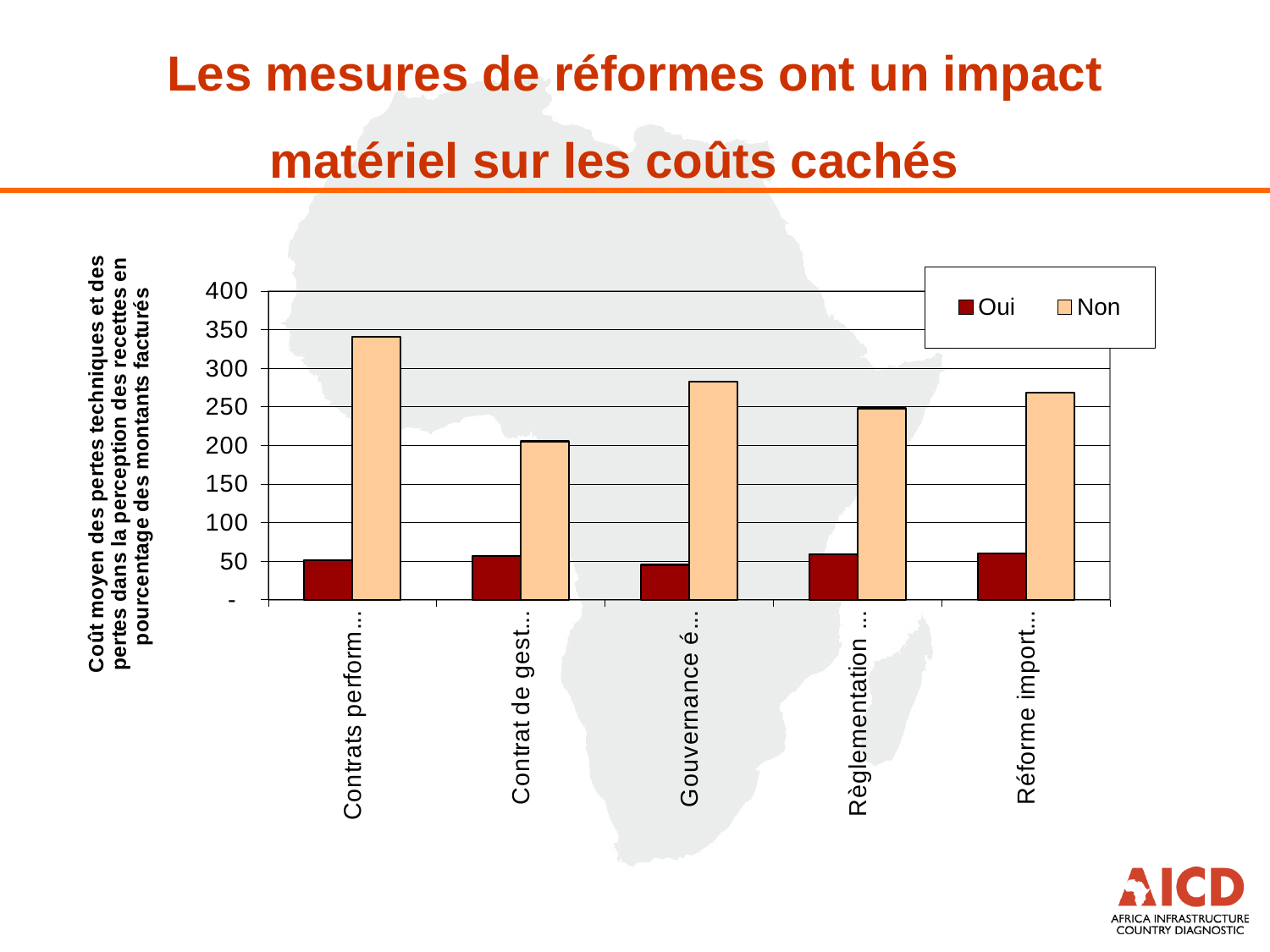
Is the Non value for the first category (Contrats perform...) greater or less than 300? greater Which colour represents the Oui series in the chart? dark red Which category has the lowest value for the Non series? Contrat de gest... (the second category) Is the Oui value for the fourth category (Règlementation ...) greater or less than 100? less For the fifth category (Réforme import...), which series has the larger value, Oui or Non? Non Is the Non value for the third category (Gouvernance é...) greater or less than 250? greater How many series does the legend list? 2 How many categories are shown on the x axis? 5 What are the two series named in the legend? Oui and Non Which category has the highest value for the Non series? Contrats perform... (the first category) What kind of chart is shown on the slide? bar chart